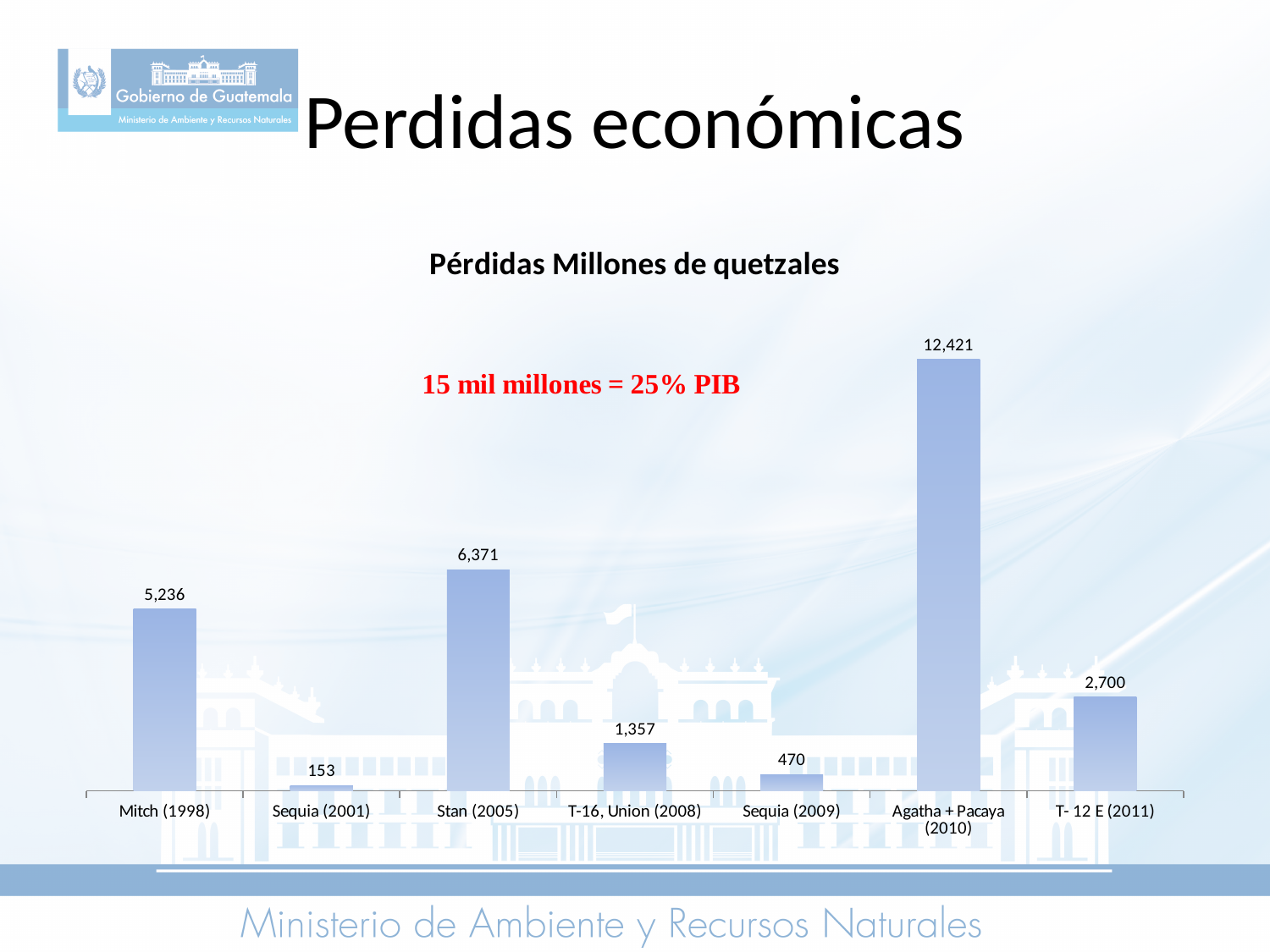
What is the difference between the values for T-16, Union (2008) and Sequia (2009)? 887 What is the value for Mitch (1998)? 5,236 What is the title of the chart? Pérdidas Millones de quetzales Which category has the highest value? Agatha + Pacaya (2010) What is the difference between the values for Stan (2005) and Mitch (1998)? 1,135 Which is larger, the value for Stan (2005) or the value for T- 12 E (2011)? Stan (2005) Which category has the lowest value? Sequia (2001) What is the value for Sequia (2009)? 470 What is the value for Agatha + Pacaya (2010)? 12,421 What is the value for T- 12 E (2011)? 2,700 What kind of chart is shown on the slide? Bar chart How many categories are shown on the x axis? 7